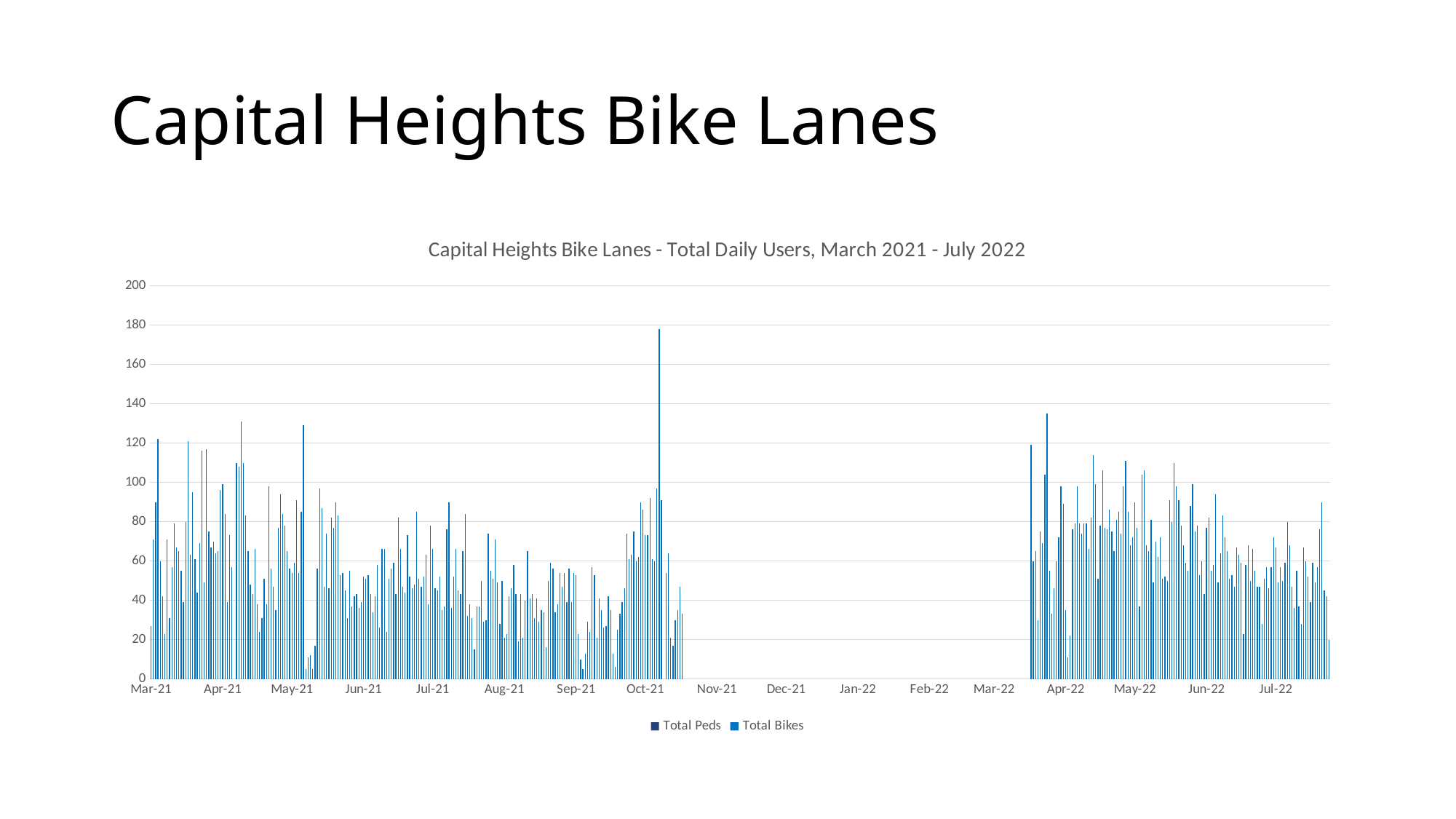
What is the title of the chart? Capital Heights Bike Lanes - Total Daily Users, March 2021 - July 2022 Is the tallest bar in the chart (in Oct-21) greater or less than 160? greater What are the names of the two series in the legend? Total Peds and Total Bikes Is the first bar at the start of Mar-21 greater or less than 100? less Which is taller: the tallest bar in Mar-21 or the tallest bar in Jun-21? Mar-21 Which is taller: the tallest bar in Oct-21 or the tallest bar in Apr-22? Oct-21 In which month does the tallest bar in the chart occur? Oct-21 How many series does the chart's legend list? 2 Is the tallest bar in Apr-22 greater or less than 120? greater What is the highest value shown on the vertical axis? 200 What kind of chart is shown on the slide? bar chart